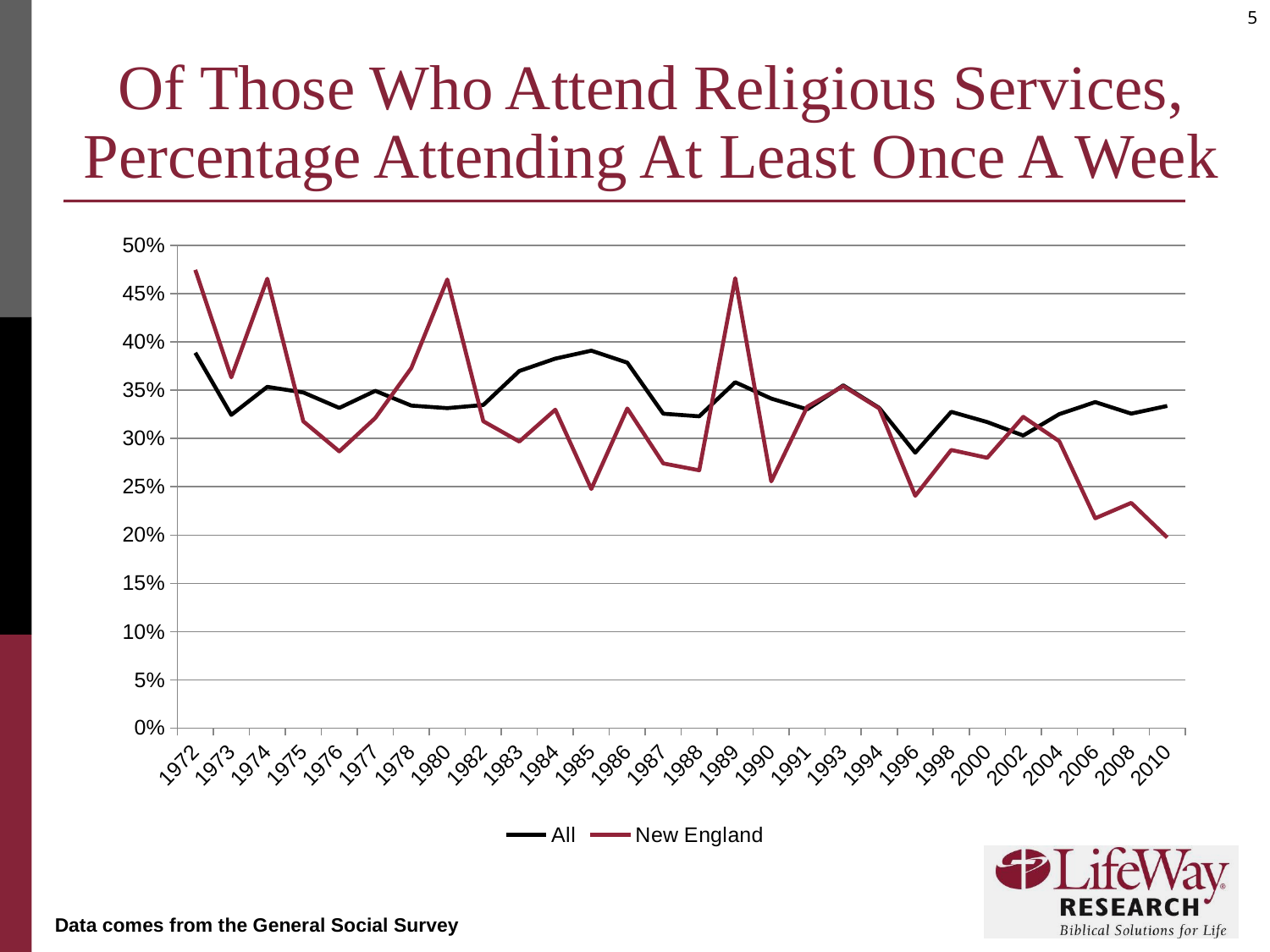
Is the value for All in 1985 greater or less than 35%? greater How many series does the legend list? 2 Is the value for All in 1996 greater or less than 30%? less In 2010, which series has the higher value, All or New England? All How many years are plotted along the x axis? 28 In 1980, which series has the higher value, All or New England? New England Is the value for New England in 1972 greater or less than 45%? greater Which series is drawn in red? New England What is the first year shown on the x axis? 1972 In which year is the New England series at its lowest? 2010 What kind of chart is shown on the slide? Line chart